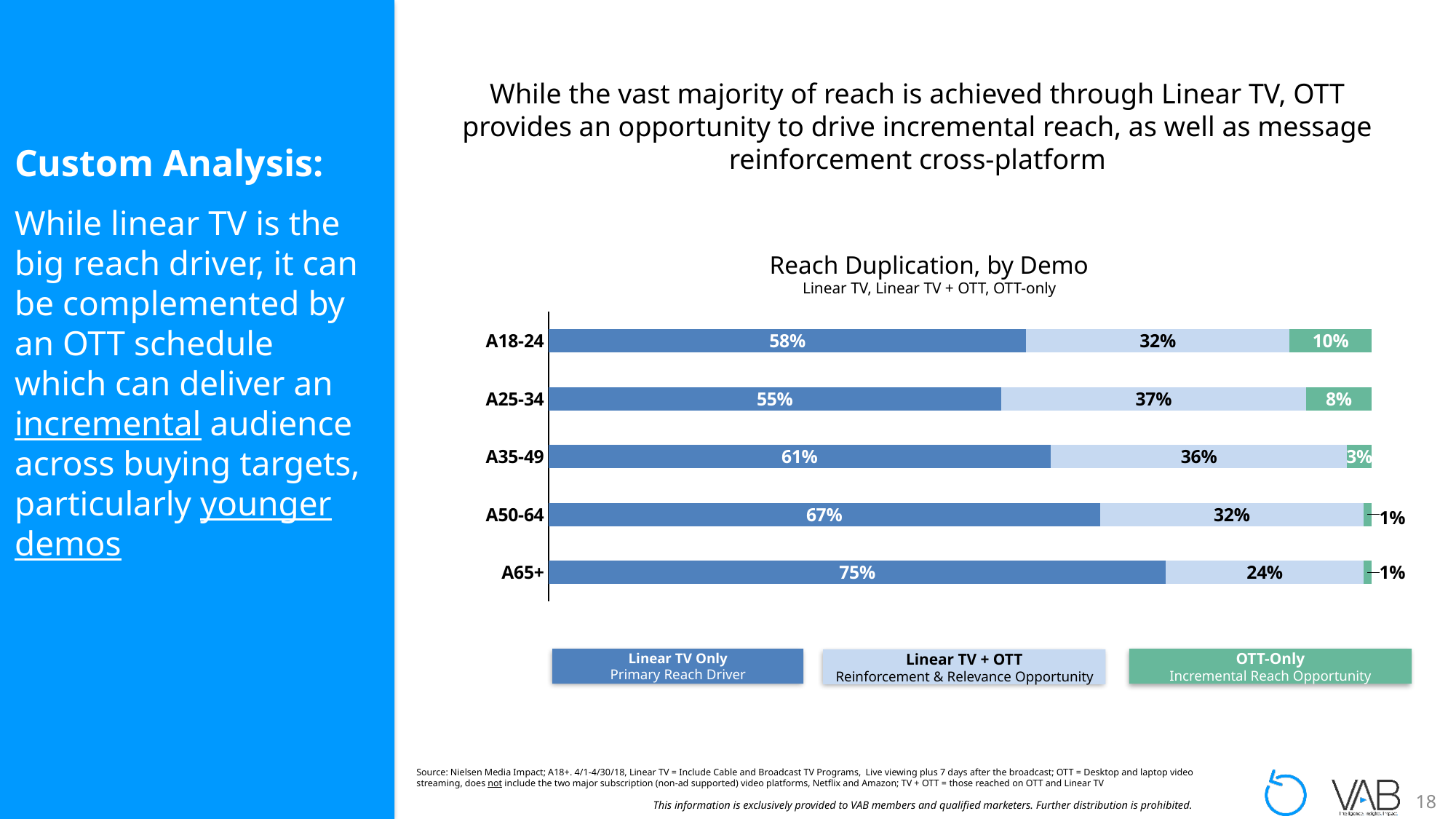
Which demo has the highest Linear TV Only value? A65+ How many demo categories are shown in the chart? 5 How many series does the legend list? 3 Which demo has the lowest Linear TV Only value? A25-34 Which is larger, the Linear TV + OTT value for A25-34 or for A65+? A25-34 What kind of chart is shown? Stacked bar chart What is the Linear TV + OTT value for A35-49? 36% Which demo has the highest OTT-Only value? A18-24 What is the difference between the Linear TV Only values for A65+ and A18-24? 17% What is the title of the chart? Reach Duplication, by Demo What is the Linear TV Only value for A18-24? 58% What is the OTT-Only value for A25-34? 8%